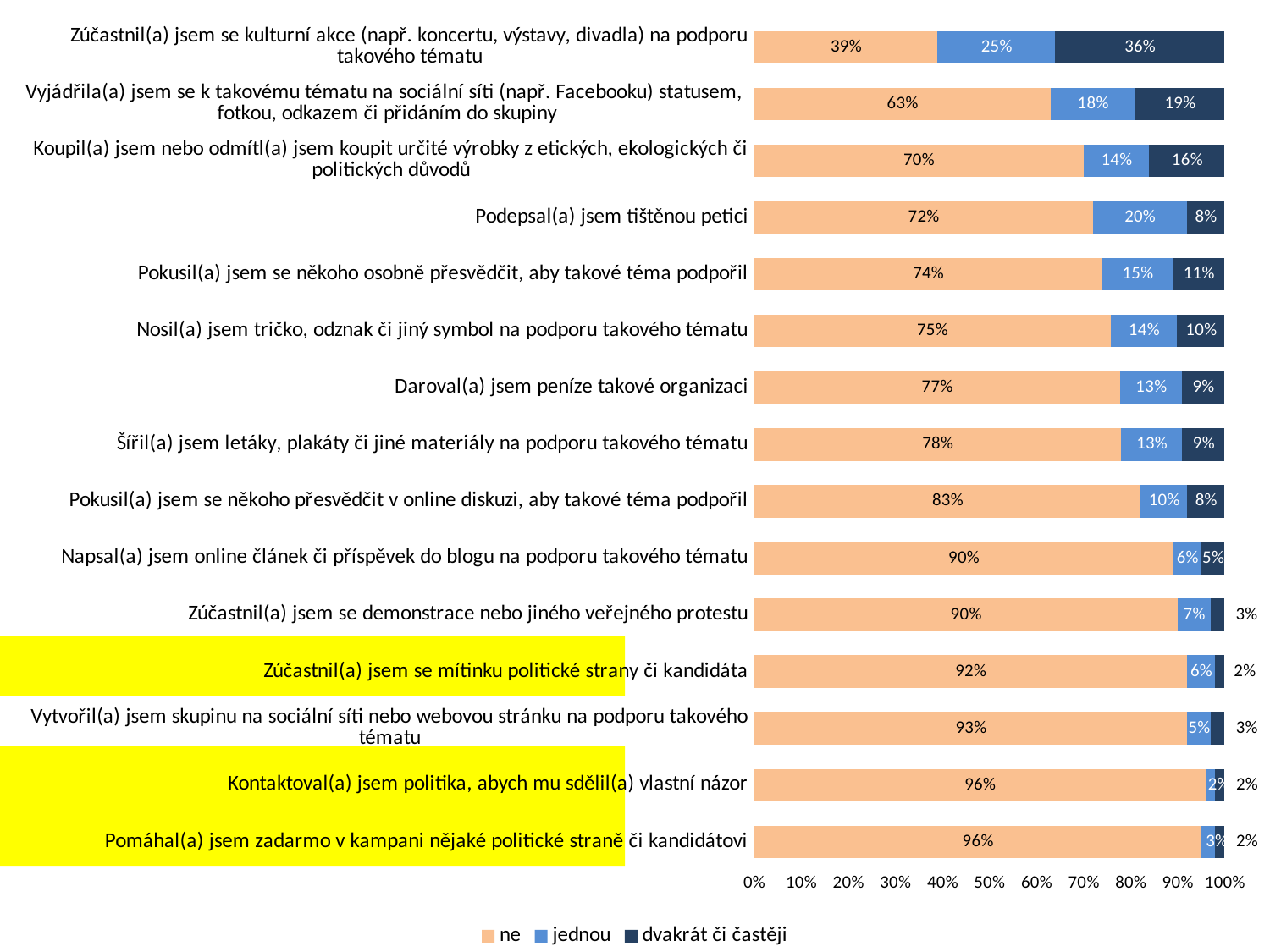
What is the difference in the "ne" series between "Daroval(a) jsem peníze takové organizaci" and "Podepsal(a) jsem tištěnou petici"? 5 percentage points What is the value of the "dvakrát či častěji" series for "Zúčastnil(a) jsem se kulturní akce (např. koncertu, výstavy, divadla) na podporu takového tématu"? 36% How many series does the legend list? 3 Which category has the lowest value for the "ne" series? Zúčastnil(a) jsem se kulturní akce (např. koncertu, výstavy, divadla) na podporu takového tématu What is the value of the "jednou" series for "Pokusil(a) jsem se někoho přesvědčit v online diskuzi, aby takové téma podpořil"? 10% What is the total of the stacked bar for "Vyjádřila(a) jsem se k takovému tématu na sociální síti (např. Facebooku) statusem, fotkou, odkazem či přidáním do skupiny"? 100% What are the three series listed in the legend? ne, jednou, dvakrát či častěji Which category has the highest value for the "jednou" series? Zúčastnil(a) jsem se kulturní akce (např. koncertu, výstavy, divadla) na podporu takového tématu What kind of chart is shown on the slide? Stacked bar chart Which has a larger "jednou" value: "Podepsal(a) jsem tištěnou petici" or "Pokusil(a) jsem se někoho osobně přesvědčit, aby takové téma podpořil"? Podepsal(a) jsem tištěnou petici How many categories are shown on the chart? 15 What is the value of the "ne" series for "Podepsal(a) jsem tištěnou petici"? 72%